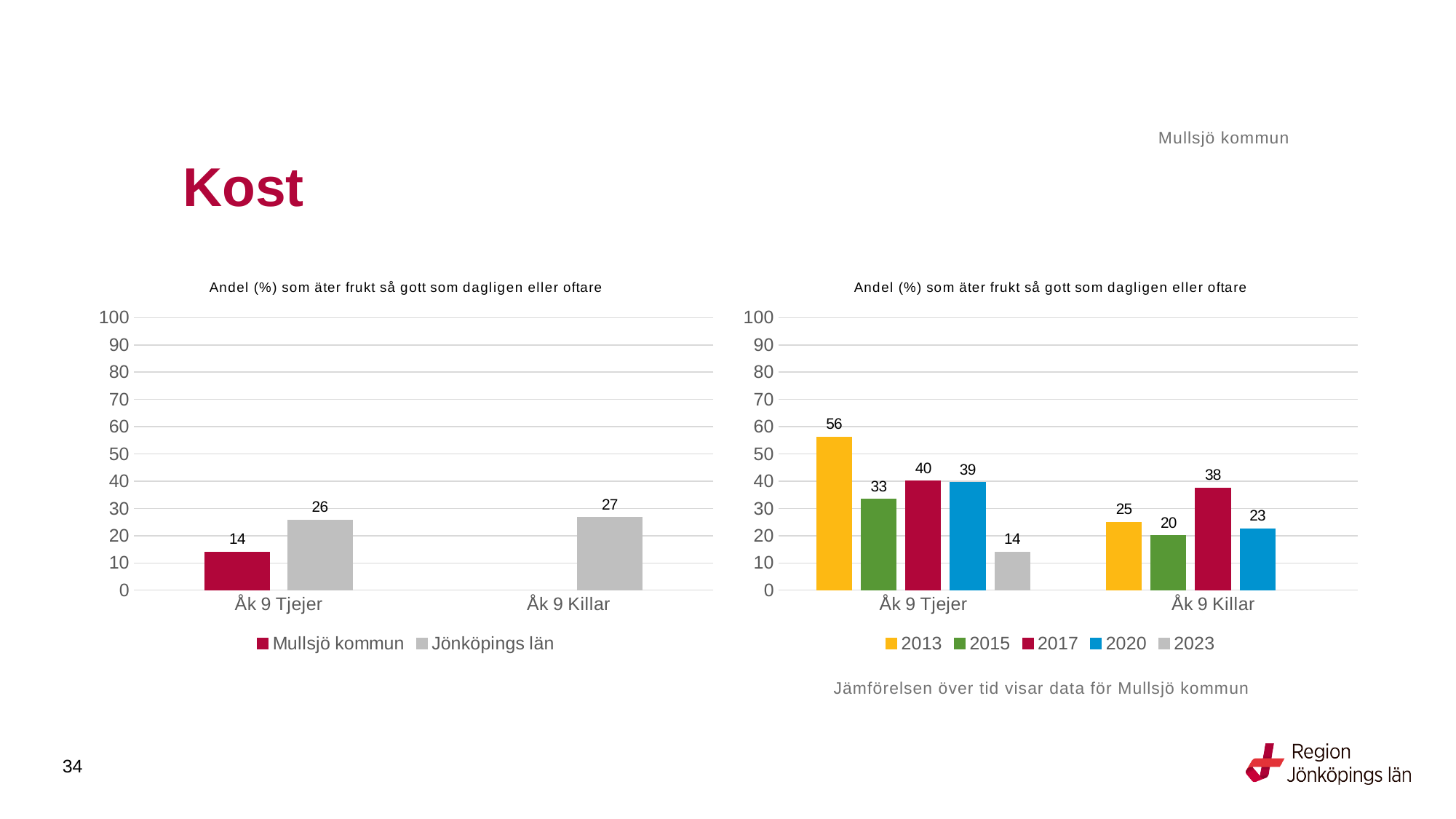
In the right chart, what is the value for 2013 for Åk 9 Tjejer? 56 In the left chart, what is the value for Jönköpings län for Åk 9 Killar? 27 In the left chart, what is the value for Mullsjö kommun for Åk 9 Tjejer? 14 What kind of chart is the right chart? Bar chart In the right chart, which is larger for Åk 9 Killar: 2017 or 2013? 2017 In the right chart, which year has the lowest value for Åk 9 Killar? 2015 In the left chart, how many series does the legend list? 2 In the right chart, how many series does the legend list? 5 In the right chart, which year has the highest value for Åk 9 Tjejer? 2013 In the right chart, what is the difference between the 2013 and 2023 values for Åk 9 Tjejer? 42 In the left chart, what is the difference between Jönköpings län and Mullsjö kommun for Åk 9 Tjejer? 12 In the right chart, what is the value for 2020 for Åk 9 Killar? 23